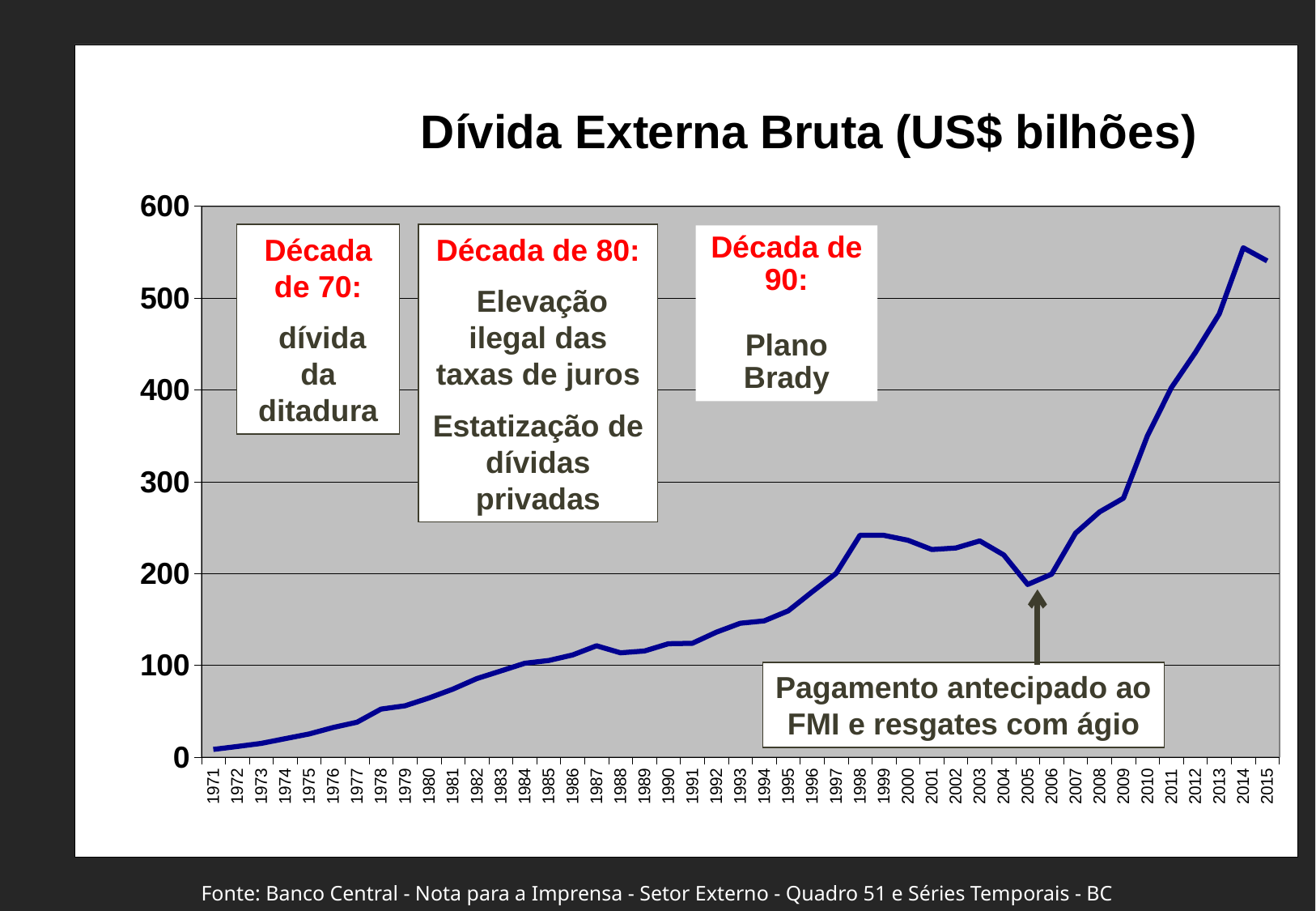
What kind of chart is shown on the slide? line chart Which event does the arrow annotation near 2005 point to? Pagamento antecipado ao FMI e resgates com ágio Is the value for 2009 greater or less than 300? less What is the title of the chart? Dívida Externa Bruta (US$ bilhões) Is the value for 1998 greater or less than 200? greater How many years are plotted along the x axis of the chart? 45 Is the value for 1971 greater or less than 100? less Overall, does the plotted value rise or fall from 1971 to 2015? rise Which year has the larger value, 2003 or 2005? 2003 In which year is the plotted value lowest? 1971 In which year does the line reach its highest value? 2014